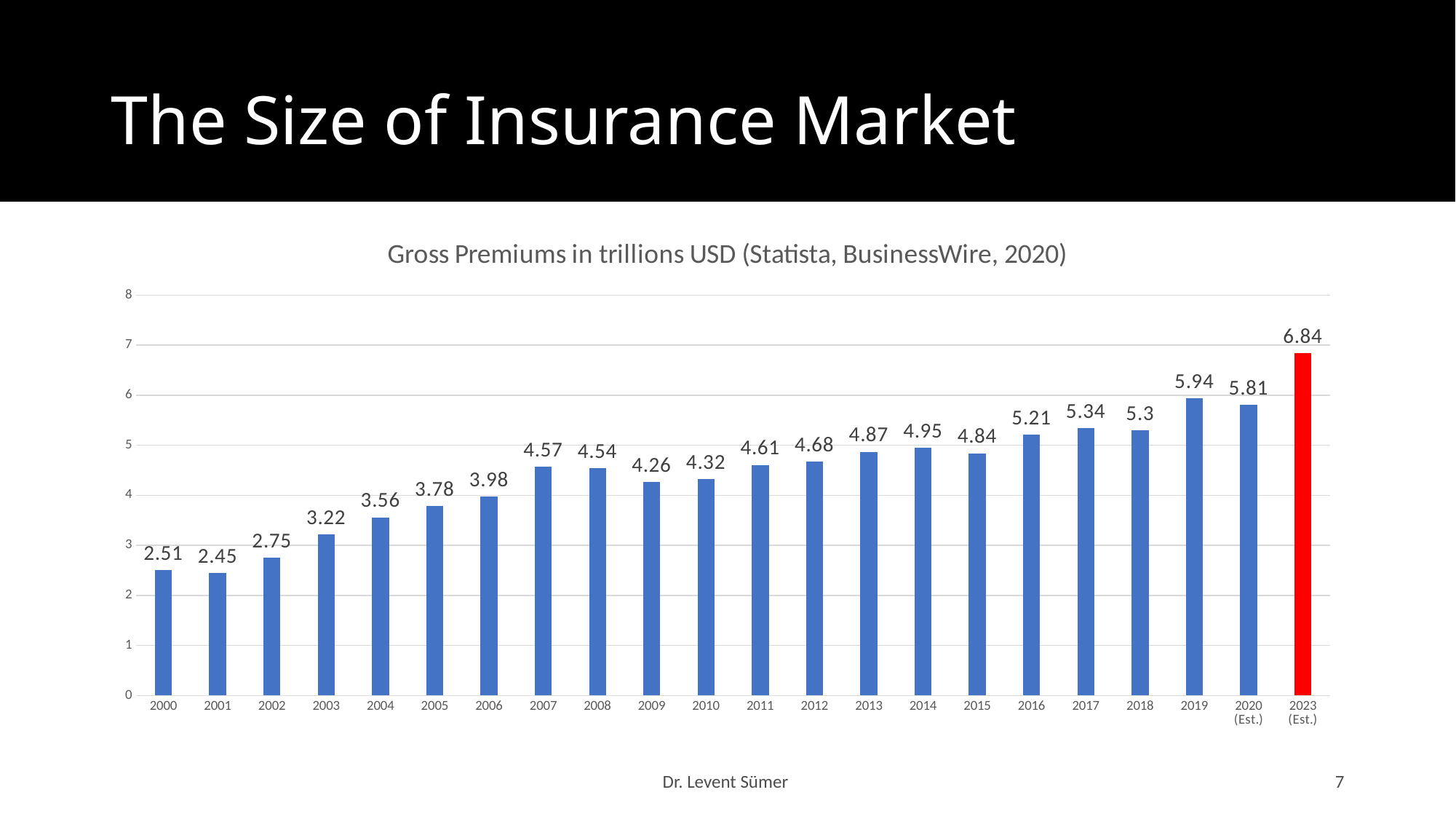
Which year has the lowest value? 2001 Is the value for 2016 greater or less than 5? greater What kind of chart is shown on the slide? Bar chart Which is larger, the value for 2008 or the value for 2009? 2008 Which bar is coloured red? 2023 (Est.) What is the value for 2007? 4.57 What is the difference between the values for 2019 and 2018? 0.64 What is the title of the chart? Gross Premiums in trillions USD (Statista, BusinessWire, 2020) Do the values generally rise or fall from 2000 to 2023 (Est.)? Rise How many bars are shown in the chart? 22 What is the value for 2020 (Est.)? 5.81 Which year has the highest value? 2023 (Est.)